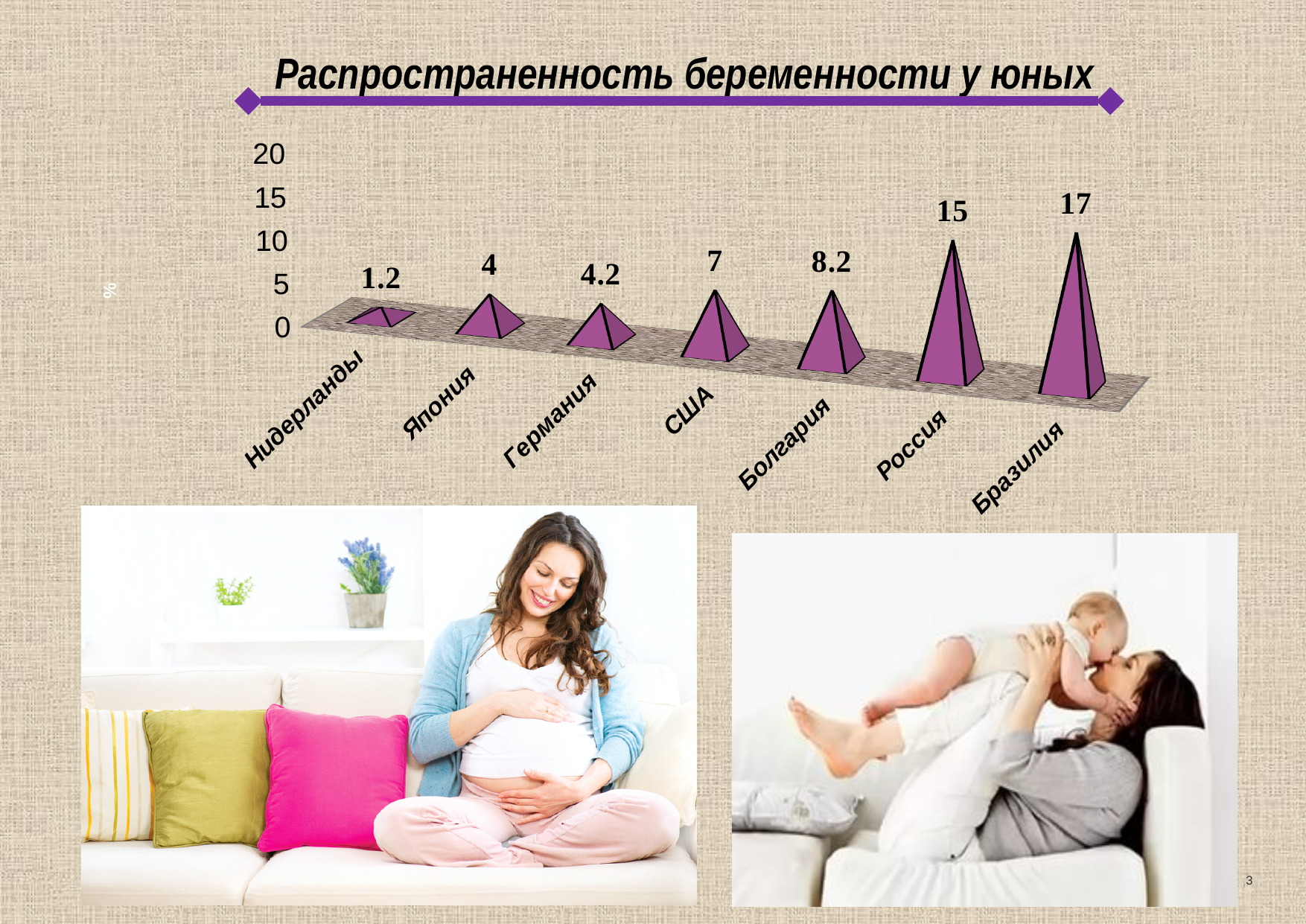
What is the value for Германия? 4.2 What is the title of the chart? Распространенность беременности у юных How many countries are shown on the chart? 7 What is the difference between the values for Болгария and США? 1.2 What is the value for Болгария? 8.2 What is the difference between the values for Бразилия and Россия? 2 Which is larger, the value for Япония or the value for США? США Which country has the highest value? Бразилия What is the value for Россия? 15 What is the value for Нидерланды? 1.2 Which country has the lowest value? Нидерланды Do the values rise or fall from left to right along the x axis? rise